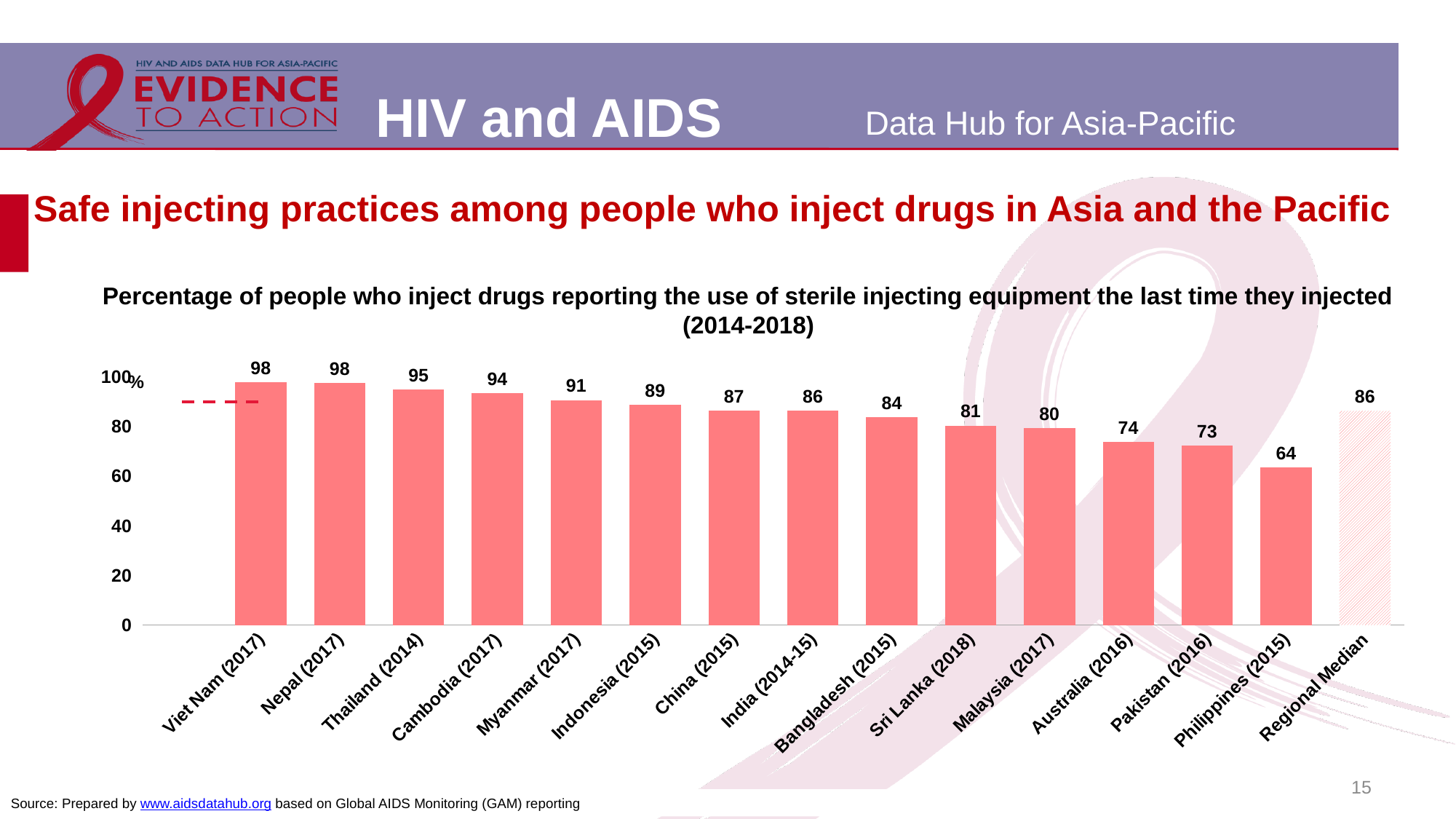
What kind of chart is shown on the slide? Bar chart What is the Regional Median value shown on the chart? 86 What is the difference between the values for Cambodia (2017) and Pakistan (2016)? 21 Do the country values rise or fall from left to right along the x axis? Fall Which has a higher value, Myanmar (2017) or Australia (2016)? Myanmar (2017) What is the value for India (2014-15)? 86 Which has a higher value, Sri Lanka (2018) or Indonesia (2015)? Indonesia (2015) How many bars are plotted on the chart, including the Regional Median? 15 What is the difference between the values for Viet Nam (2017) and Philippines (2015)? 34 What is the value for Thailand (2014)? 95 What is the value for Malaysia (2017)? 80 Which country has the lowest value on the chart? Philippines (2015)